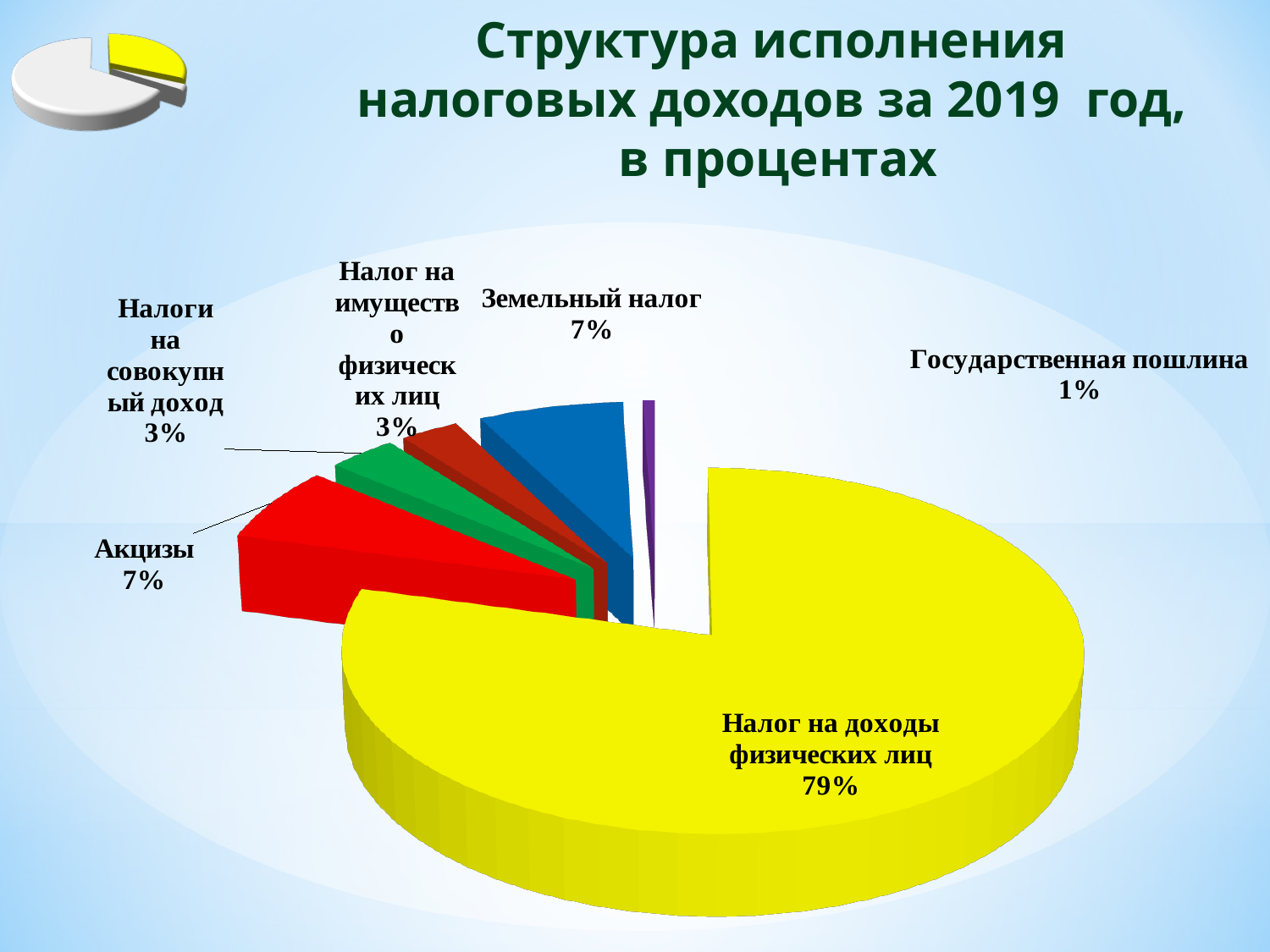
What share of the pie does Налог на доходы физических лиц have? 79% What kind of chart is shown on the slide? Pie chart How many slices does the pie chart have? 6 What is the value shown for Акцизы? 7% Which is larger, the share for Земельный налог or the share for Налог на имущество физических лиц? Земельный налог What is the value shown for Земельный налог? 7% Which category has the largest slice of the pie? Налог на доходы физических лиц What is the value shown for Налоги на совокупный доход? 3% What is the value shown for Государственная пошлина? 1% What colour is the slice for Налог на доходы физических лиц? Yellow Which category has the smallest slice of the pie? Государственная пошлина What is the difference between the shares of Налог на доходы физических лиц and Акцизы? 72%